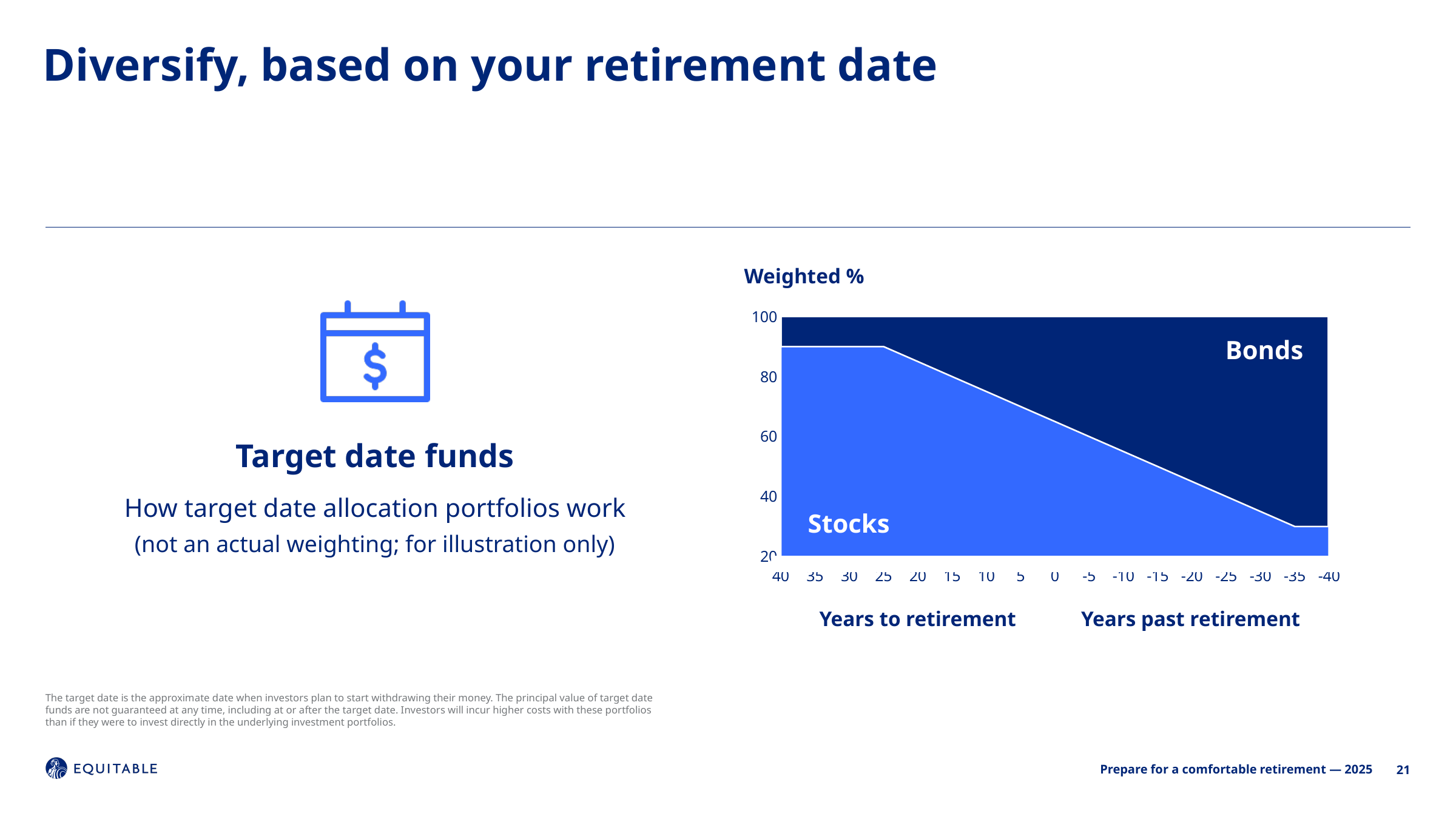
Is the Stocks weighting at 40 years to retirement greater or less than 80? greater Does the Stocks weighting rise or fall as you move from left to right along the x axis? Fall What is the title of the vertical axis of the chart? Weighted % Is the Stocks weighting at 35 years to retirement greater or less than 80? greater Does the Bonds weighting rise or fall as you move from left to right along the x axis? Rise What kind of chart is shown on the slide? Area chart At -40 years past retirement, which has the larger weighting, Stocks or Bonds? Bonds At 40 years to retirement, which has the larger weighting, Stocks or Bonds? Stocks Is the Stocks weighting at -40 years past retirement greater or less than 40? less How many tick labels are shown on the x axis of the chart? 17